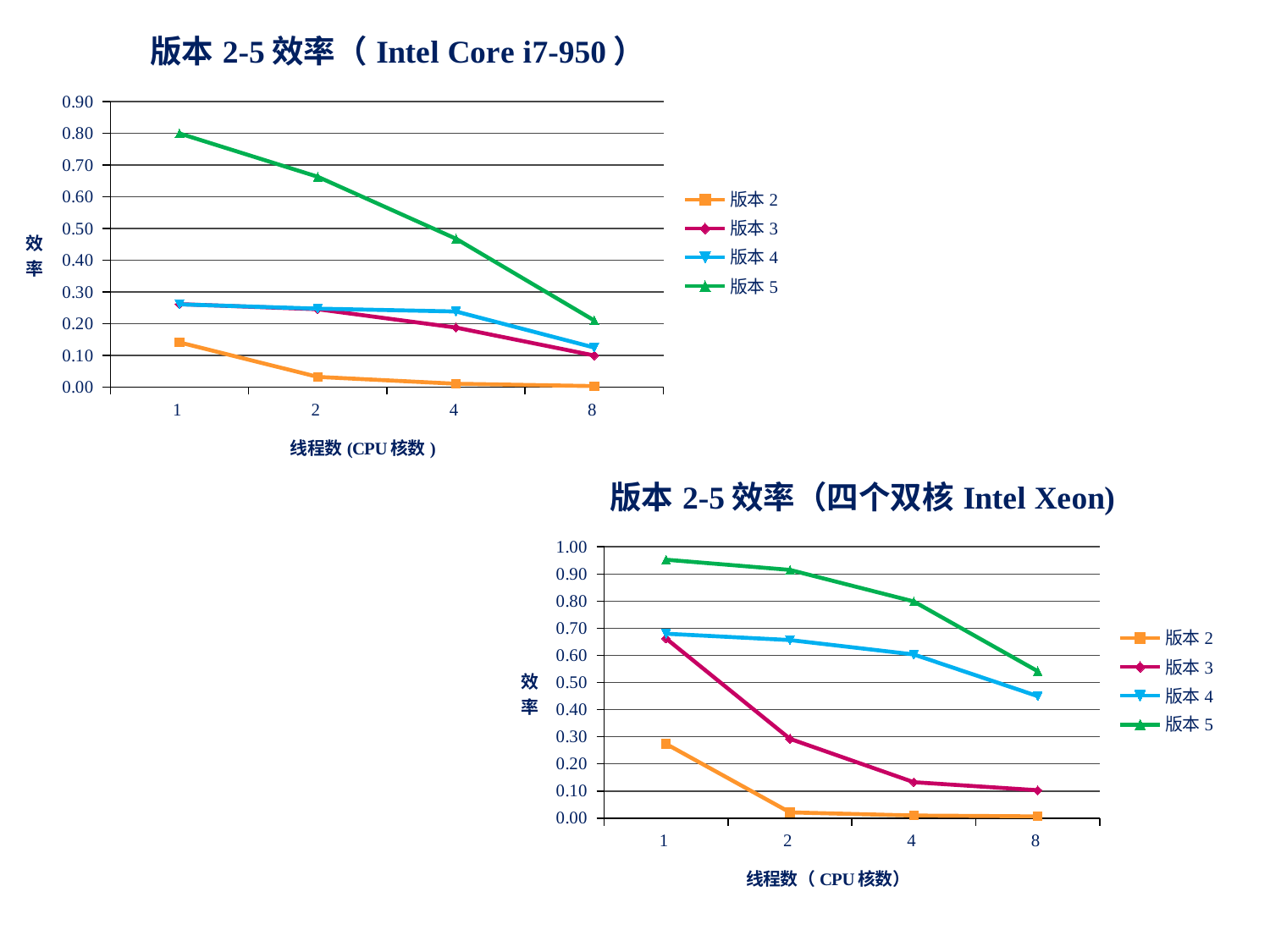
What is the x-axis label of the bottom chart (四个双核 Intel Xeon)? 线程数 （ CPU 核数） In the top chart (Intel Core i7-950), is the value for 版本 5 at 2 threads greater or less than 0.60? greater In the top chart (Intel Core i7-950), does the efficiency of 版本 5 rise or fall as the number of threads increases? fall In the top chart (Intel Core i7-950), which series has the lowest efficiency at 8 threads? 版本 2 How many series does the legend of the bottom chart (四个双核 Intel Xeon) list? 4 How many x-axis categories (thread counts) are plotted in the top chart (Intel Core i7-950)? 4 In the bottom chart (四个双核 Intel Xeon), which is larger at 2 threads: 版本 3 or 版本 4? 版本 4 In the bottom chart (四个双核 Intel Xeon), is the value for 版本 5 at 1 thread greater or less than 0.90? greater In the bottom chart (四个双核 Intel Xeon), is the value for 版本 4 at 8 threads greater or less than 0.50? less In the top chart (Intel Core i7-950), which series has the highest efficiency at 1 thread? 版本 5 What kind of chart is the top chart titled 版本 2-5 效率 ( Intel Core i7-950 )? line chart